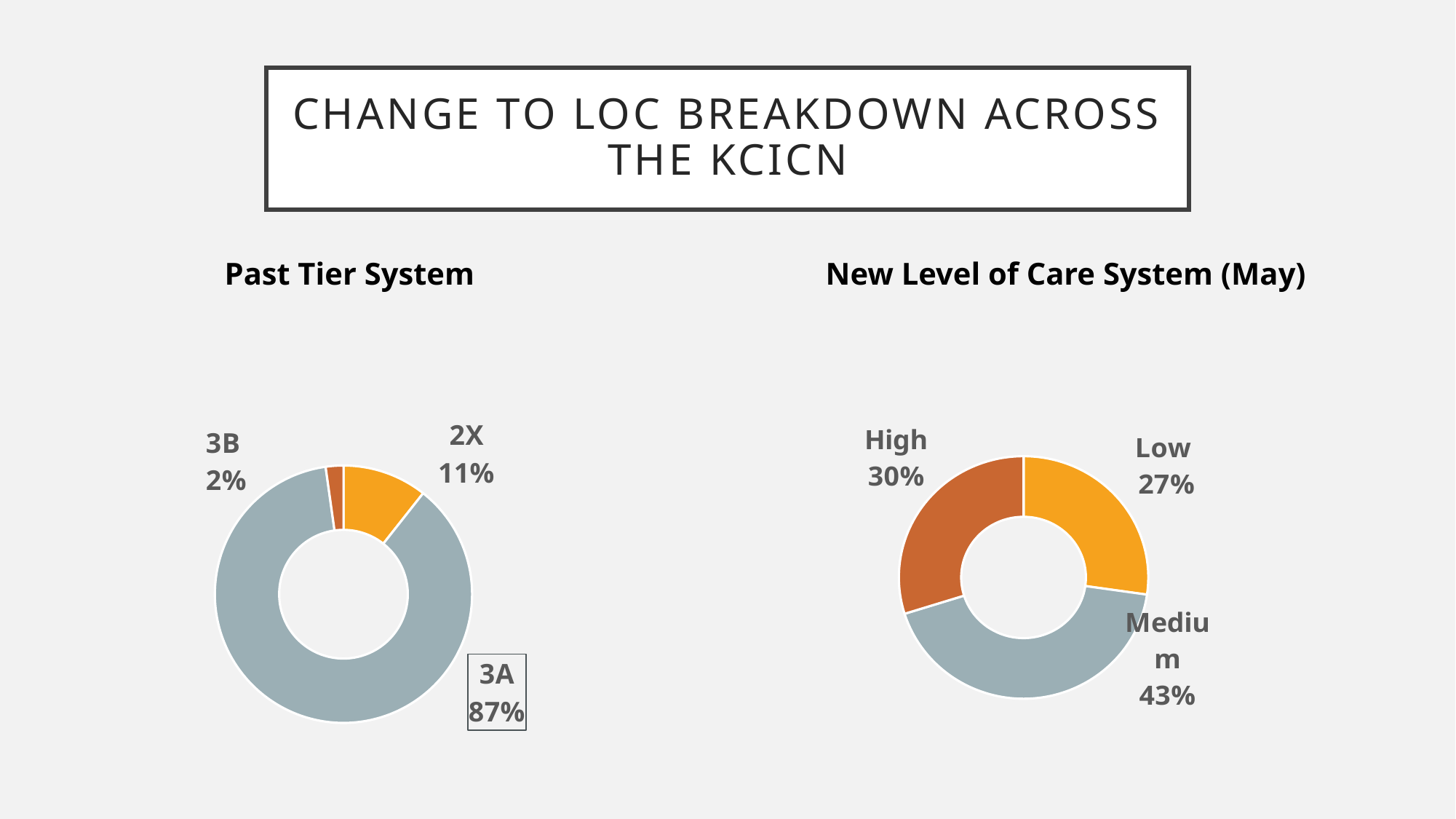
How many categories are shown in the New Level of Care System (May) chart? 3 In the New Level of Care System (May) chart, what share does High have? 30% In the Past Tier System chart, what is the difference between the 3A and 2X shares? 76% What kind of chart is the Past Tier System chart? Doughnut chart In the Past Tier System chart, what share does 2X have? 11% In the Past Tier System chart, which is larger, 2X or 3B? 2X In the Past Tier System chart, what share does 3B have? 2% In the New Level of Care System (May) chart, which category has the smallest share? Low In the Past Tier System chart, what share does 3A have? 87% In the New Level of Care System (May) chart, what is the difference between the Medium and Low shares? 16% In the New Level of Care System (May) chart, what share does Medium have? 43% In the Past Tier System chart, which category has the largest share? 3A